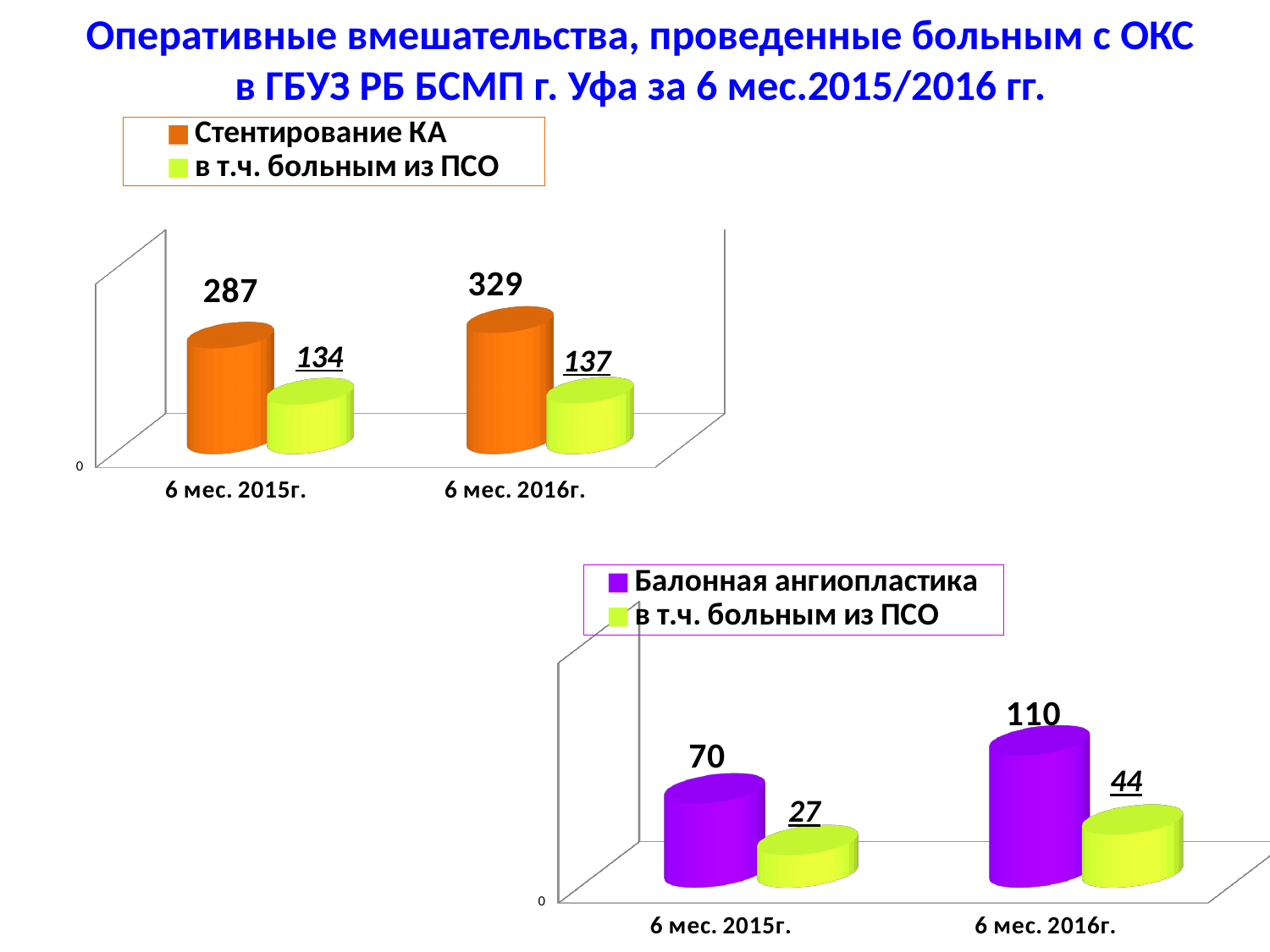
In the bottom chart (Балонная ангиопластика), what is the value for в т.ч. больным из ПСО in 6 мес. 2015г.? 27 In the top chart, what colour are the bars for Стентирование КА? orange What kind of chart is the bottom chart (Балонная ангиопластика)? bar chart In the bottom chart (Балонная ангиопластика), how many categories are shown on the x axis? 2 In the bottom chart (Балонная ангиопластика), what is the value for Балонная ангиопластика in 6 мес. 2016г.? 110 In the top chart (Стентирование КА), what is the value for в т.ч. больным из ПСО in 6 мес. 2016г.? 137 In the top chart (Стентирование КА), what is the difference between Стентирование КА in 6 мес. 2016г. and 6 мес. 2015г.? 42 In the top chart (Стентирование КА), how many series does the legend list? 2 In the top chart (Стентирование КА), does the value for Стентирование КА rise or fall from 6 мес. 2015г. to 6 мес. 2016г.? rise In the top chart (Стентирование КА), what is the value for Стентирование КА in 6 мес. 2015г.? 287 In the bottom chart (Балонная ангиопластика), what is the difference between в т.ч. больным из ПСО in 6 мес. 2016г. and 6 мес. 2015г.? 17 In the bottom chart (Балонная ангиопластика), which is larger: Балонная ангиопластика in 6 мес. 2015г. or в т.ч. больным из ПСО in 6 мес. 2016г.? Балонная ангиопластика in 6 мес. 2015г.